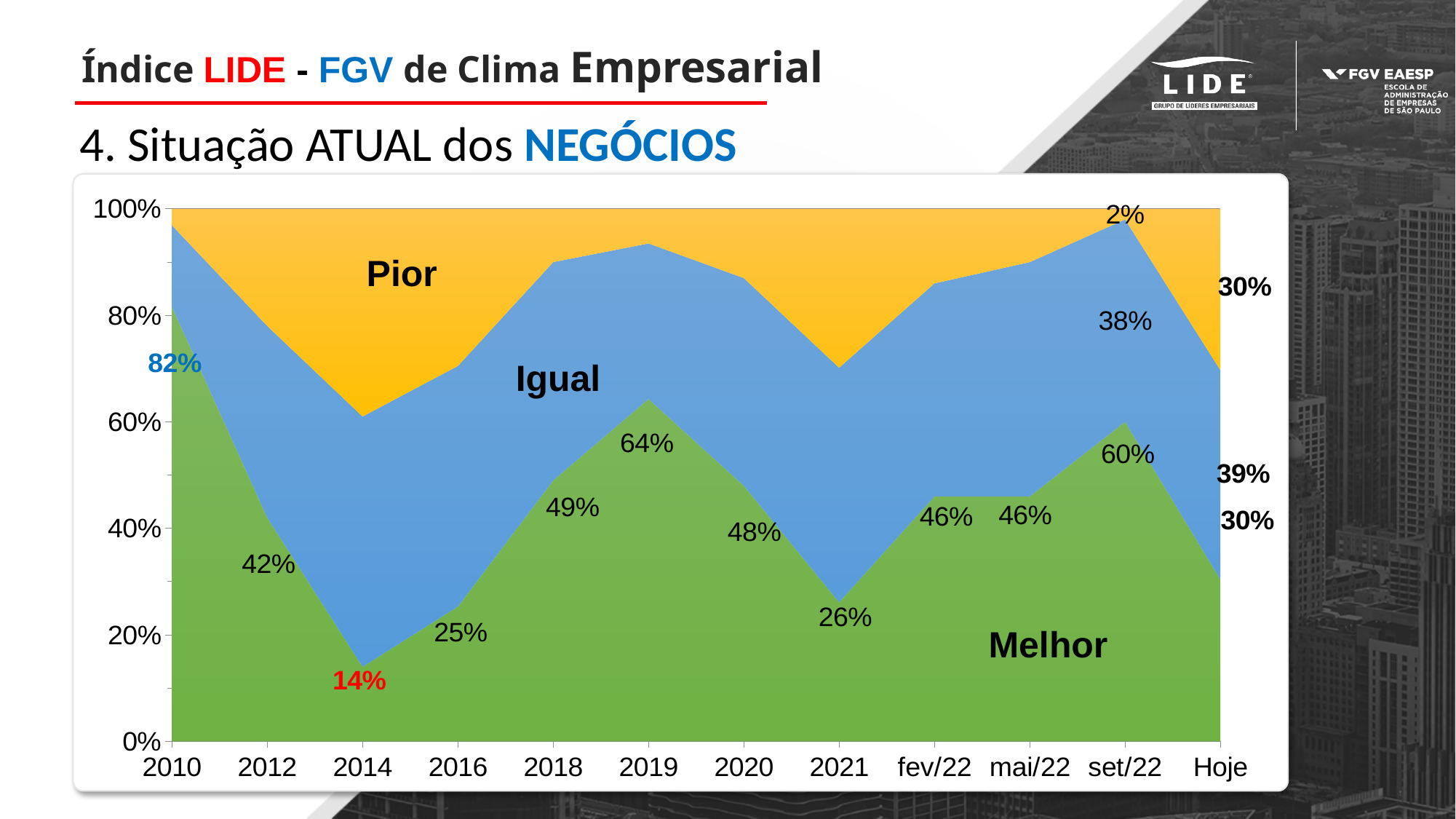
What is the Melhor value for 2014? 14% How many periods are shown on the x axis? 12 Does the Melhor value rise or fall from 2010 to 2014? Fall What is the difference between the Melhor value for 2010 and the Melhor value for 2014? 68 percentage points What is the Melhor value for 2010? 82% What is the Pior value for Hoje? 30% Which is larger, the Melhor value for 2019 or the Melhor value for 2021? 2019 In which period is the Melhor value lowest? 2014 Is the Pior value for 2014 greater or less than 20%? greater What kind of chart is shown? Stacked area chart In which period is the Melhor value highest? 2010 What is the Igual value for set/22? 38%